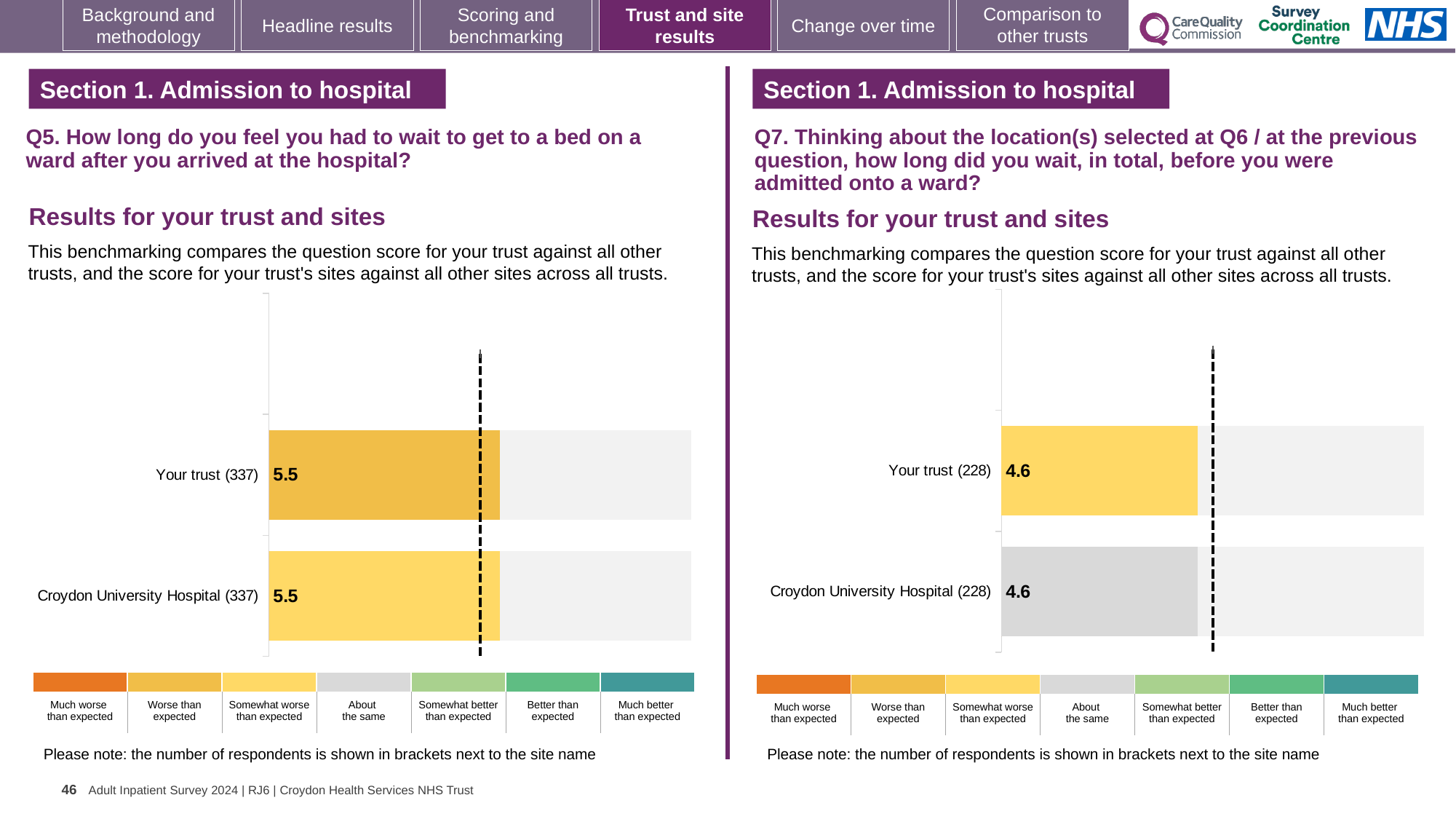
On the Q7 chart (right), how many respondents are shown in brackets for Croydon University Hospital? 228 How many bars are plotted on the Q7 chart (right)? 2 On the Q5 chart (left), what is the score for Your trust? 5.5 On the Q5 chart (left), what is the score for Croydon University Hospital? 5.5 What kind of chart is used on the Q5 chart (left)? Bar chart On the Q7 chart (right), what is the score for Your trust? 4.6 On the Q5 chart (left), how many respondents are shown in brackets for Your trust? 337 On the Q7 chart (right), what is the score for Croydon University Hospital? 4.6 On the Q7 chart (right), what is the difference between the score for Your trust and the score for Croydon University Hospital? 0.0 How many bars are plotted on the Q5 chart (left)? 2 On the Q5 chart (left), what is the difference between the score for Your trust and the score for Croydon University Hospital? 0.0